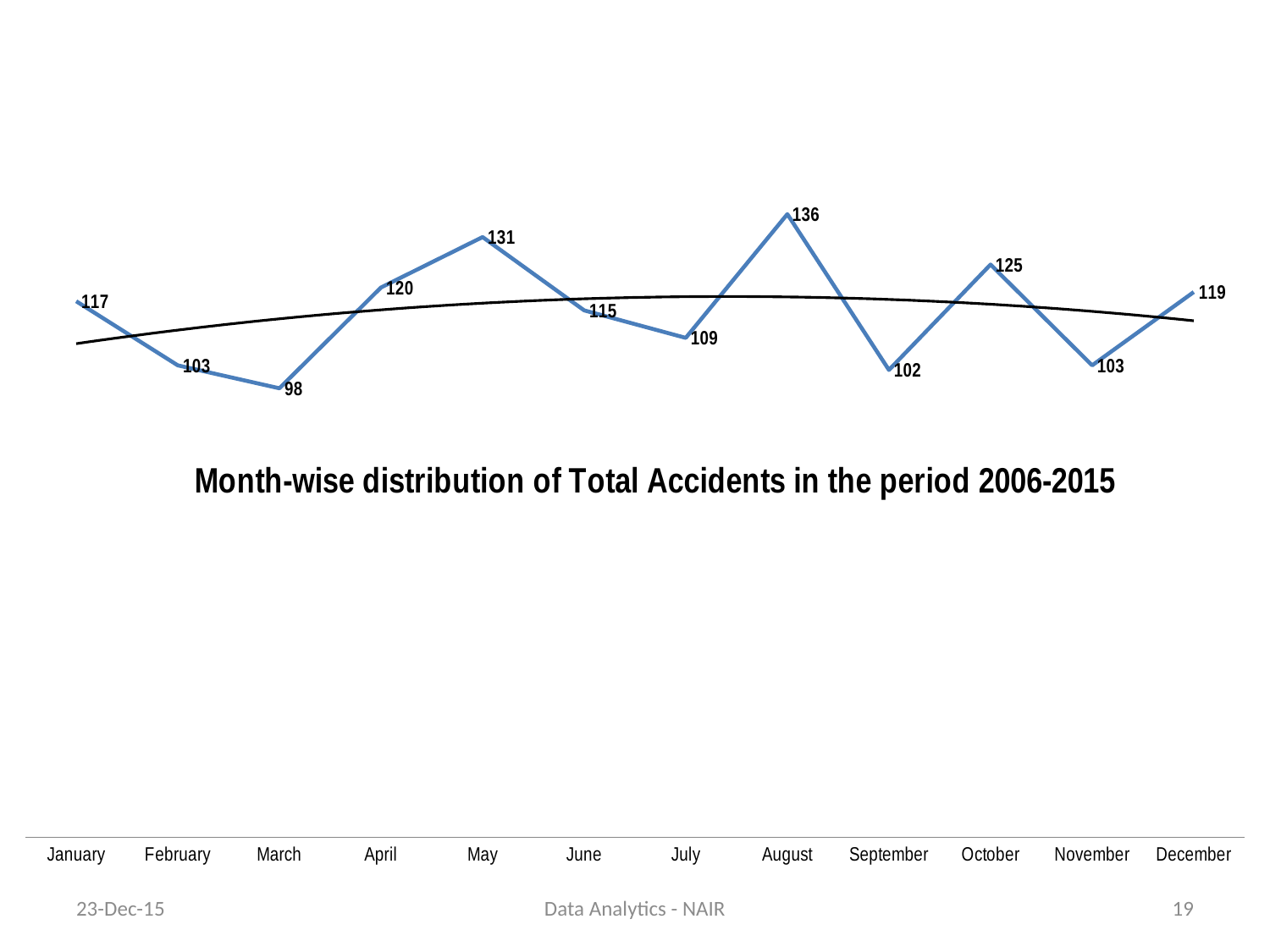
Which month has the lowest value? March Do the values rise or fall from January to March? fall What is the difference between the values for May and June? 16 Which month has the highest value? August What kind of chart is this? line chart What is the value for August? 136 How many months are plotted on the x axis? 12 Which is larger, the value for October or the value for April? October What is the difference between the values for August and September? 34 What is the value for March? 98 What is the title of the chart? Month-wise distribution of Total Accidents in the period 2006-2015 What is the value for December? 119